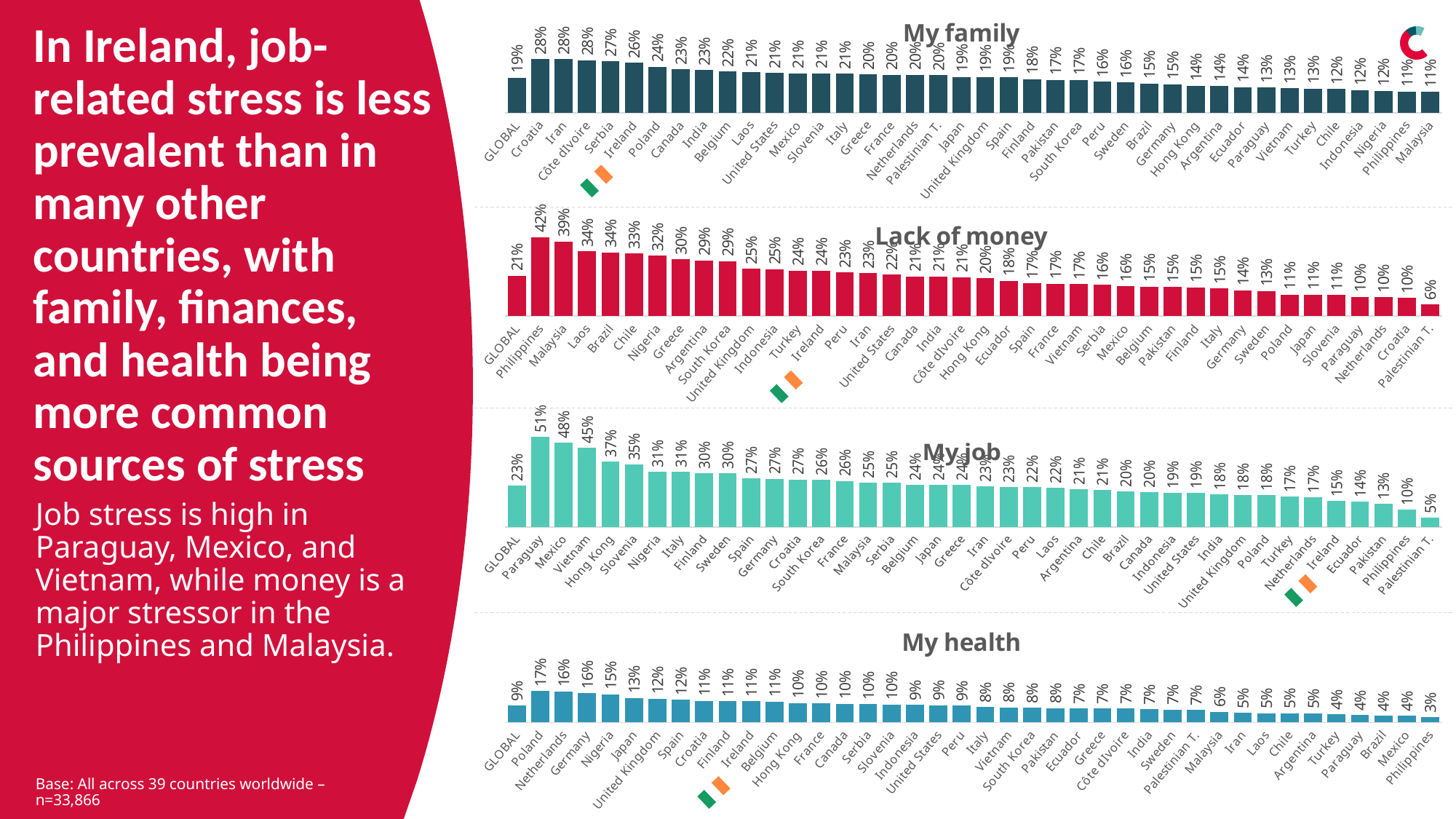
In the 'My health' chart, which is larger, Poland or Ireland? Poland In the 'My job' chart, what is the difference between Paraguay and Ireland? 36 percentage points How many bars are plotted in the 'Lack of money' chart? 40 In the 'My health' chart, what is the GLOBAL value? 9% What type of chart is the 'My job' chart? Bar chart In the 'My job' chart, which country has the highest value? Paraguay In the 'Lack of money' chart, which country has the highest value? Philippines In the 'My health' chart, which country has the lowest value? Philippines In the 'My family' chart, what is the difference between Croatia and Malaysia? 17 percentage points In the 'Lack of money' chart, what is the value for Malaysia? 39% In the 'My job' chart, which has the lowest value? Palestinian T. In the 'My family' chart, what is the value for Ireland? 26%